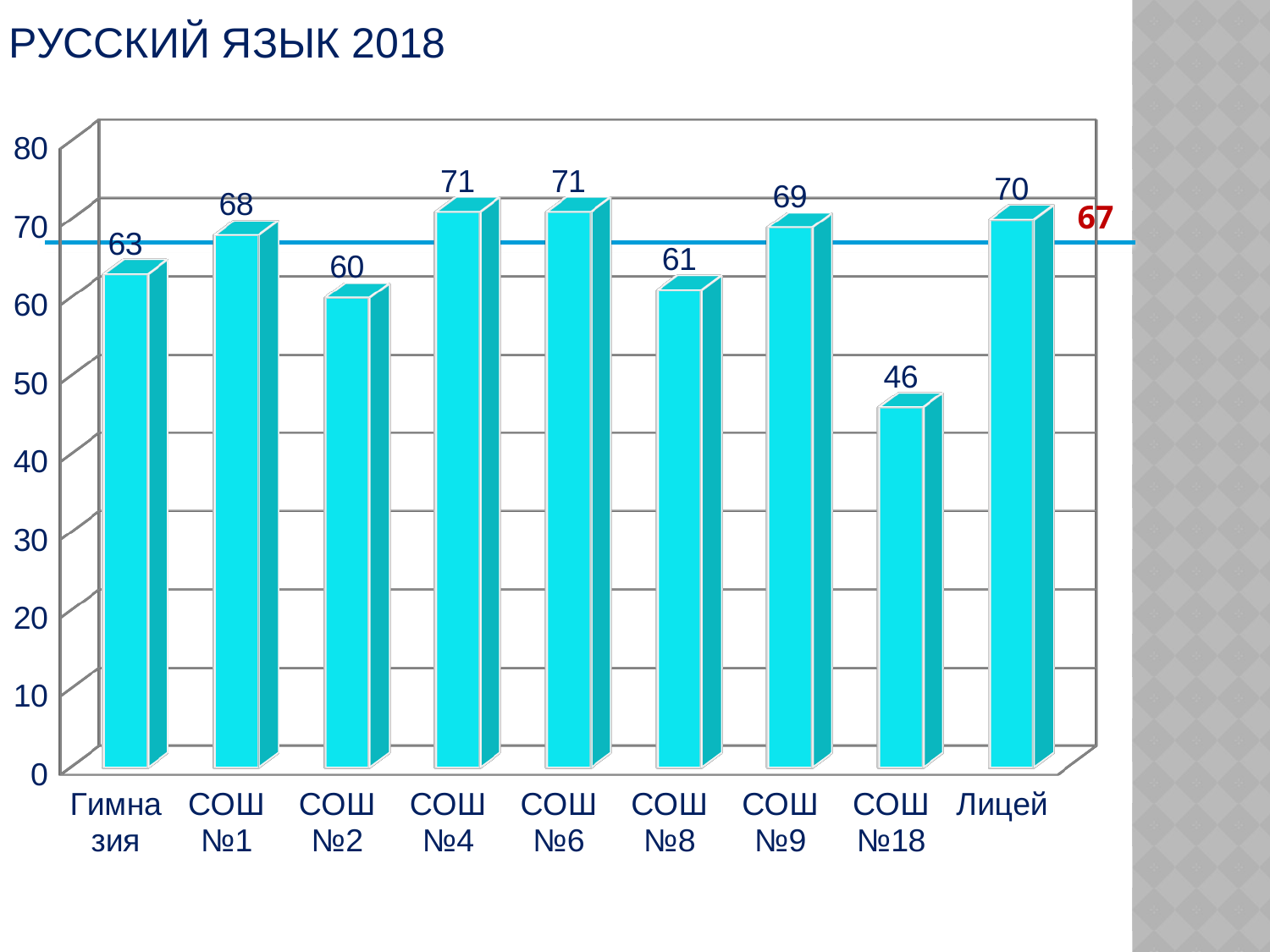
What is the highest value shown on the chart? 71 What is the value for Лицей? 70 What kind of chart is this? bar chart What is the value for СОШ №18? 46 What is the value for Гимназия? 63 What is the value for СОШ №9? 69 Which is larger, the value for СОШ №8 or the value for СОШ №9? СОШ №9 What value is marked by the horizontal line across the chart? 67 What is the difference between the values for Лицей and СОШ №18? 24 Which category has the lowest value? СОШ №18 What is the difference between the values for СОШ №1 and СОШ №2? 8 How many categories are shown on the chart? 9